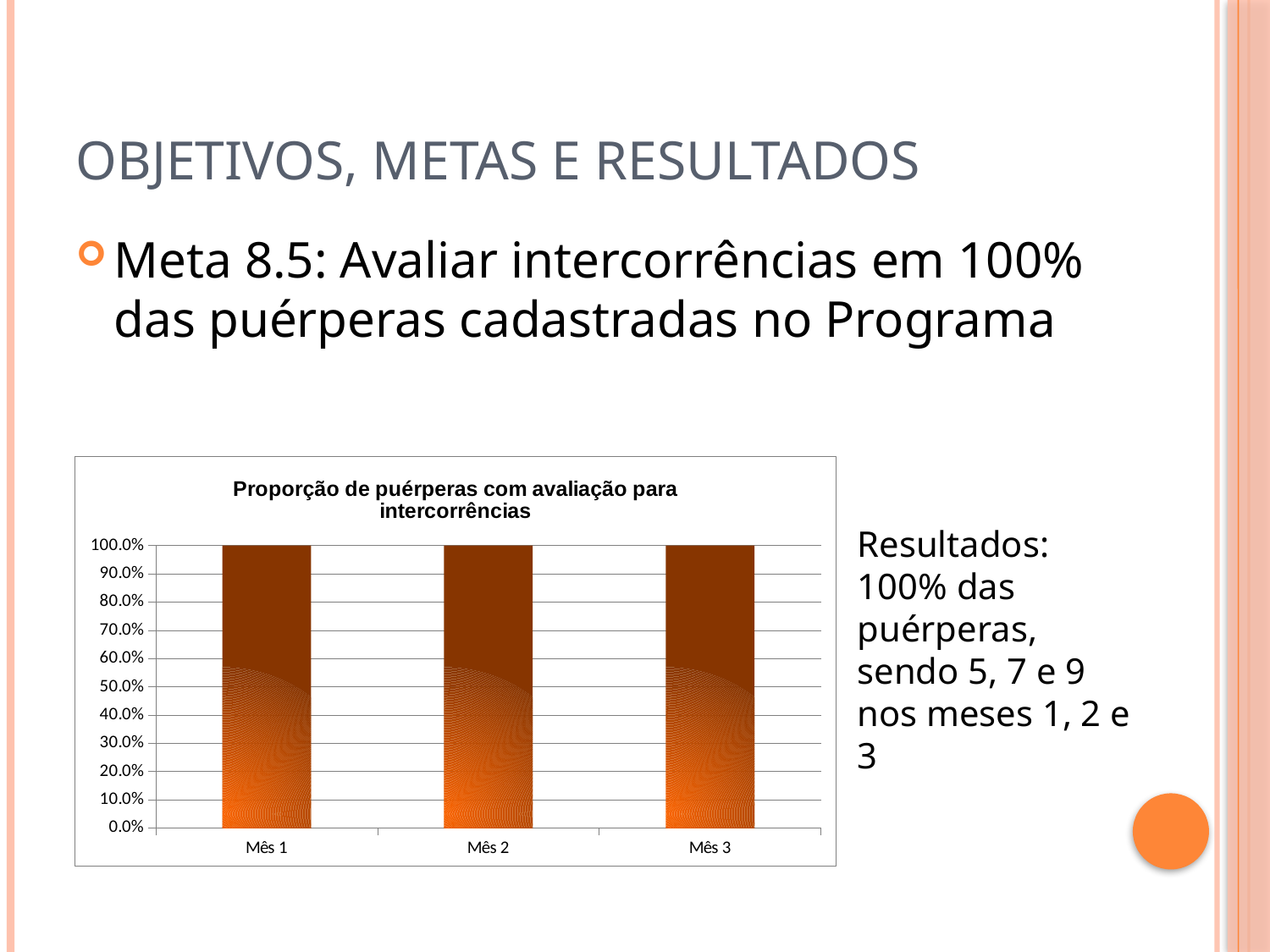
What is the value for Mês 3? 100.0% What is the highest value shown on the y axis of the chart? 100.0% Is the value for Mês 3 greater or less than 50.0%? greater What colour are the bars in the chart? orange What is the title of the chart? Proporção de puérperas com avaliação para intercorrências What is the difference between the values for Mês 1 and Mês 3? 0.0% What is the value for Mês 1? 100.0% How many categories are shown on the x axis of the chart? 3 Do the values rise, fall or stay the same from Mês 1 to Mês 3? stay the same What kind of chart is shown on the slide? bar chart Is the value for Mês 2 greater or less than 90.0%? greater What is the value for Mês 2? 100.0%